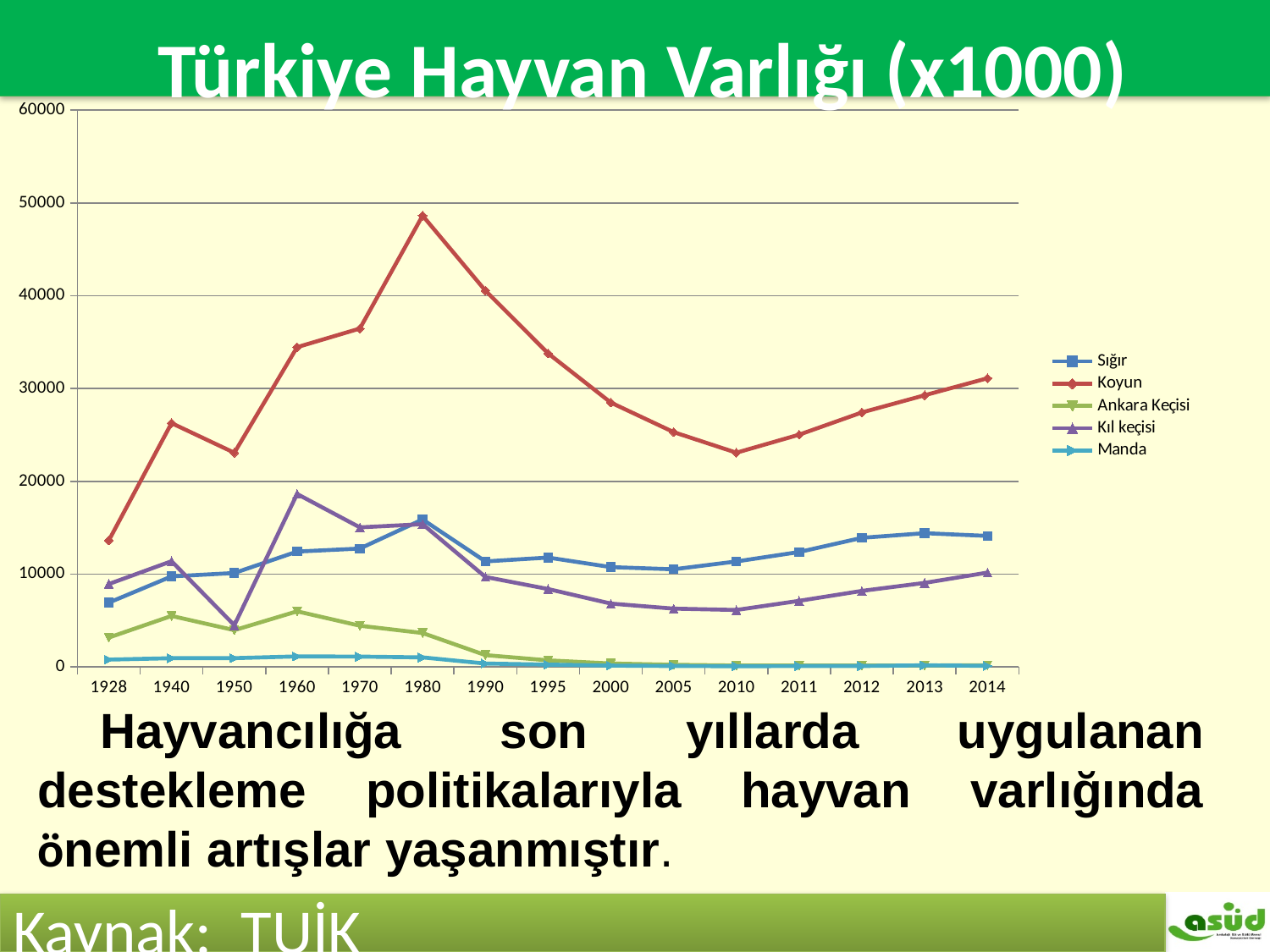
Is the value for Sığır in 2014 greater or less than 10000? greater Which series has the highest values across the chart? Koyun Which series has the lowest values across the chart? Manda In which year does the Koyun series reach its peak? 1980 Is the value for Koyun in 1980 greater or less than 40000? greater What kind of chart is shown on the slide? line chart Which is larger in 1960, the value for Kıl keçisi or the value for Sığır? Kıl keçisi What is the title of the chart? Türkiye Hayvan Varlığı (x1000) How many years are shown along the x axis? 15 How many series does the legend list? 5 Is the value for Kıl keçisi in 2010 greater or less than 10000? less Does the Koyun series rise or fall between 2010 and 2014? rise